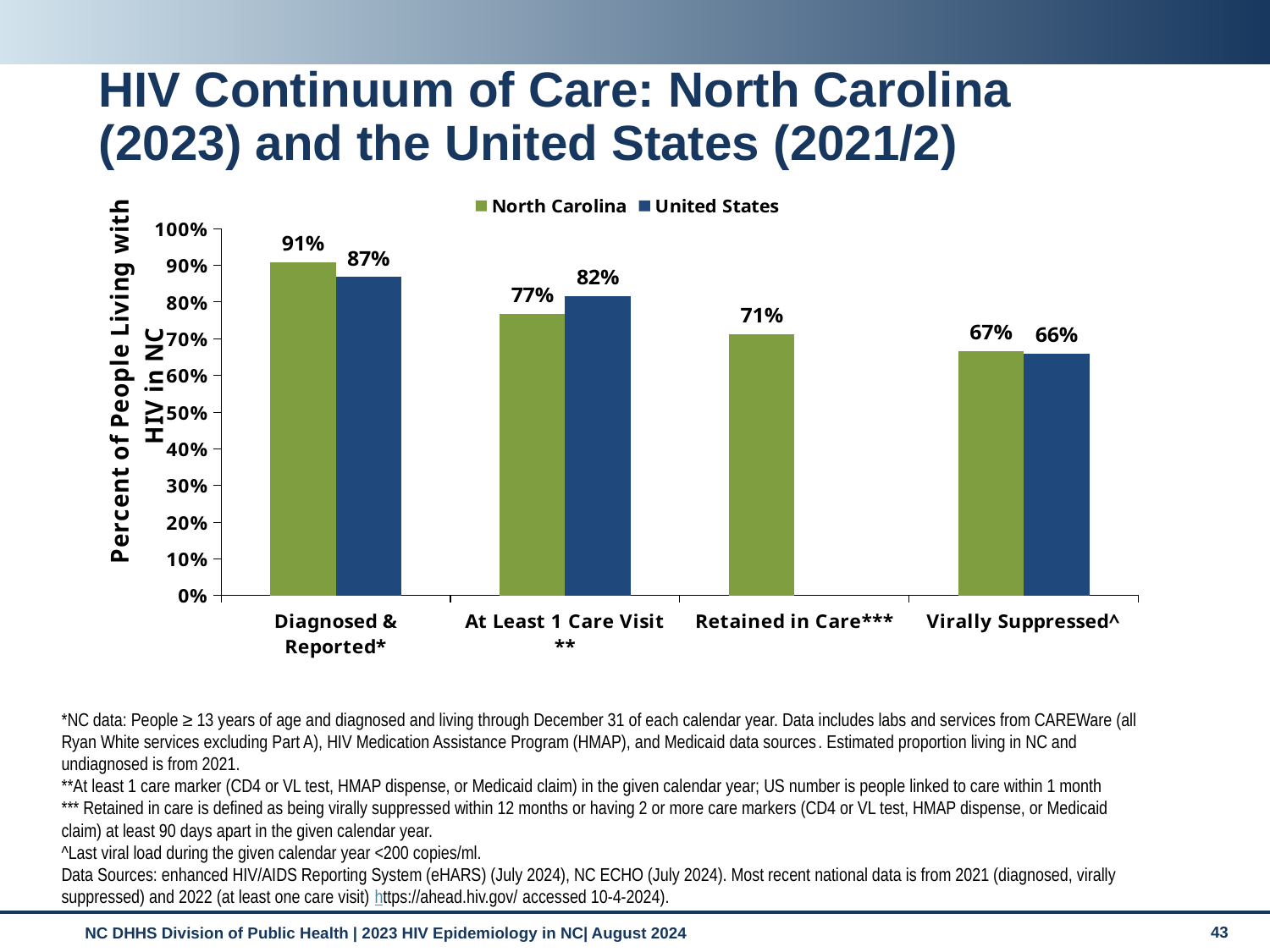
Which category has the highest North Carolina value? Diagnosed & Reported* How many series does the legend list? 2 What is the United States value for Virally Suppressed^? 66% How many categories are shown on the x axis? 4 What kind of chart is shown on the slide? Bar chart What is the North Carolina value for Retained in Care***? 71% Which category has the lowest North Carolina value? Virally Suppressed^ What is the North Carolina value for Diagnosed & Reported*? 91% Which category has no United States bar? Retained in Care*** For Diagnosed & Reported*, which is larger: the North Carolina value or the United States value? North Carolina What is the difference between the North Carolina and United States values for At Least 1 Care Visit **? 5% What is the United States value for At Least 1 Care Visit **? 82%